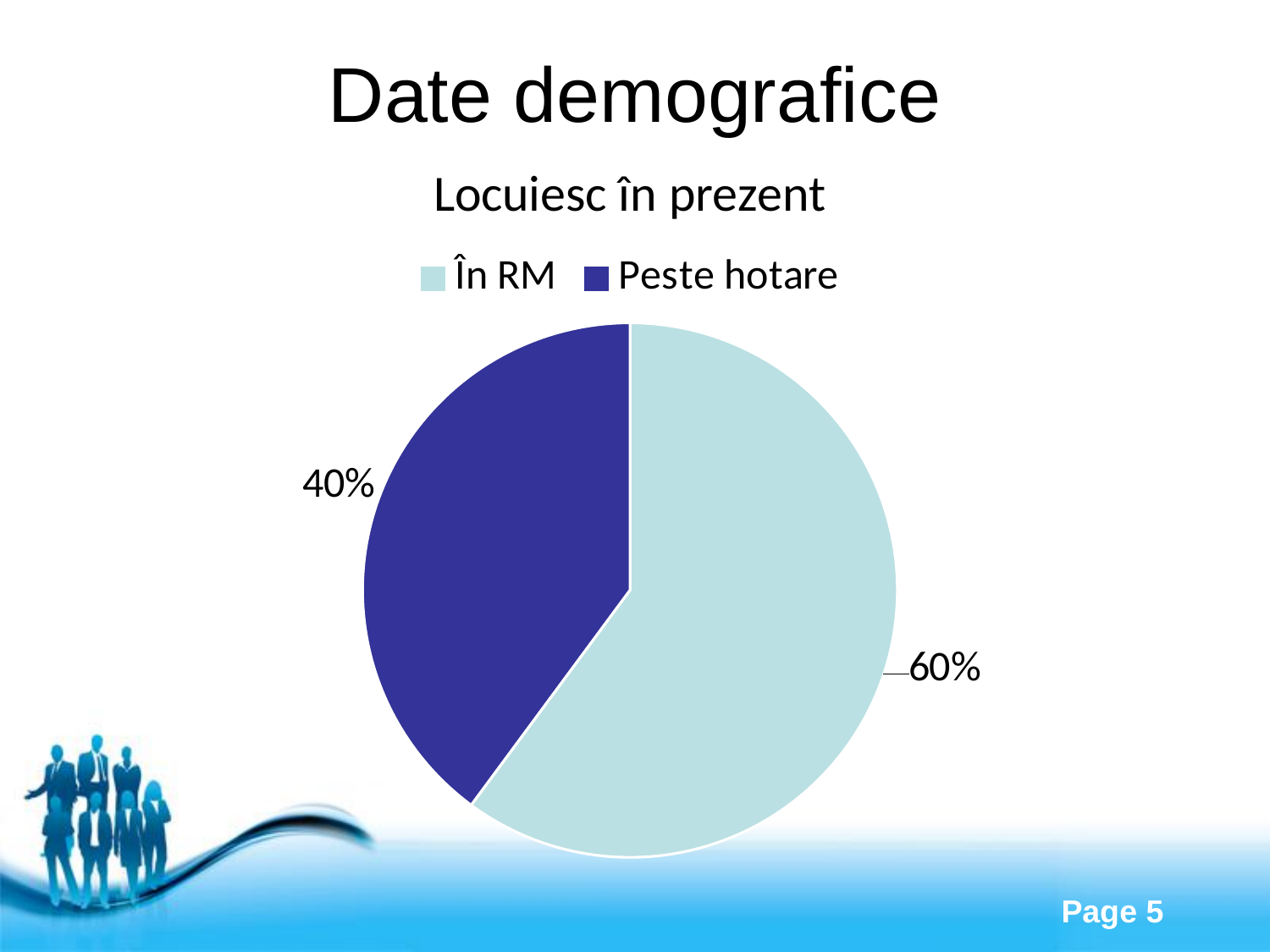
What percentage of the pie is labelled for Peste hotare? 40% Which category has the largest share of the pie? În RM What share of the pie does the În RM slice represent? 60% How many slices does the pie chart have? 2 How many entries does the legend list? 2 What is the difference in percentage points between În RM and Peste hotare? 20% What type of chart is shown on the slide? pie chart Which category has the smallest share of the pie? Peste hotare What is the title of the chart? Locuiesc în prezent What colour is the slice for Peste hotare? dark blue Which is larger, the share for În RM or the share for Peste hotare? În RM What percentage of the pie is labelled for În RM? 60%